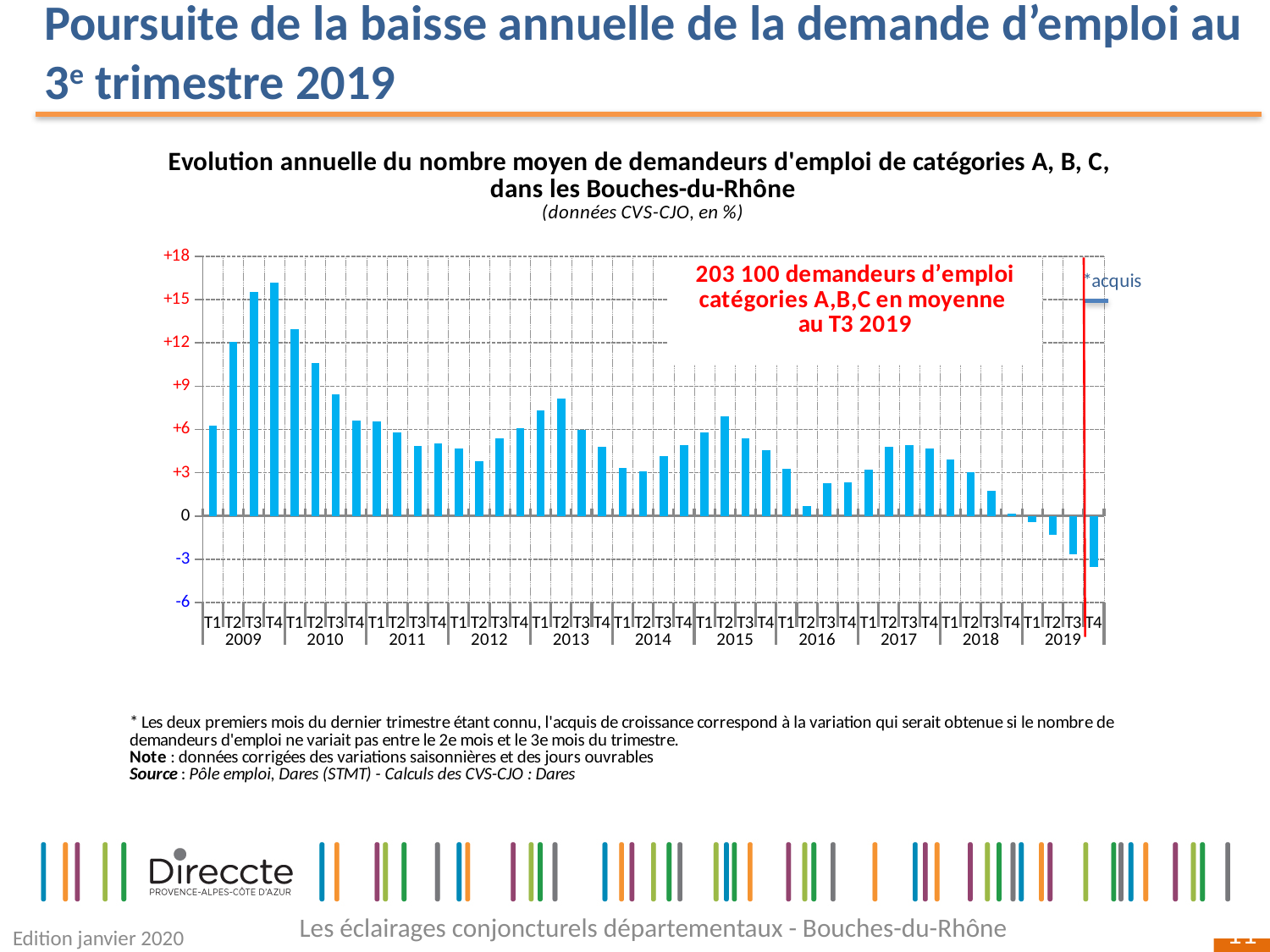
Is the value for T1 2010 greater or less than +12? greater Is the value for T4 2019 greater or less than -3? less Which is larger, the value for T2 2013 or the value for T1 2016? T2 2013 Which quarter has the highest value in the chart? T4 2009 Is the value for T3 2010 greater or less than +9? less Which quarter has the lowest value in the chart? T4 2019 Do the values rise or fall from T4 2009 to T1 2011? fall According to the annotation on the chart, how many demandeurs d'emploi catégories A,B,C were there on average in T3 2019? 203 100 What kind of chart is shown on the slide? bar chart How many years are covered on the x axis of the chart? 11